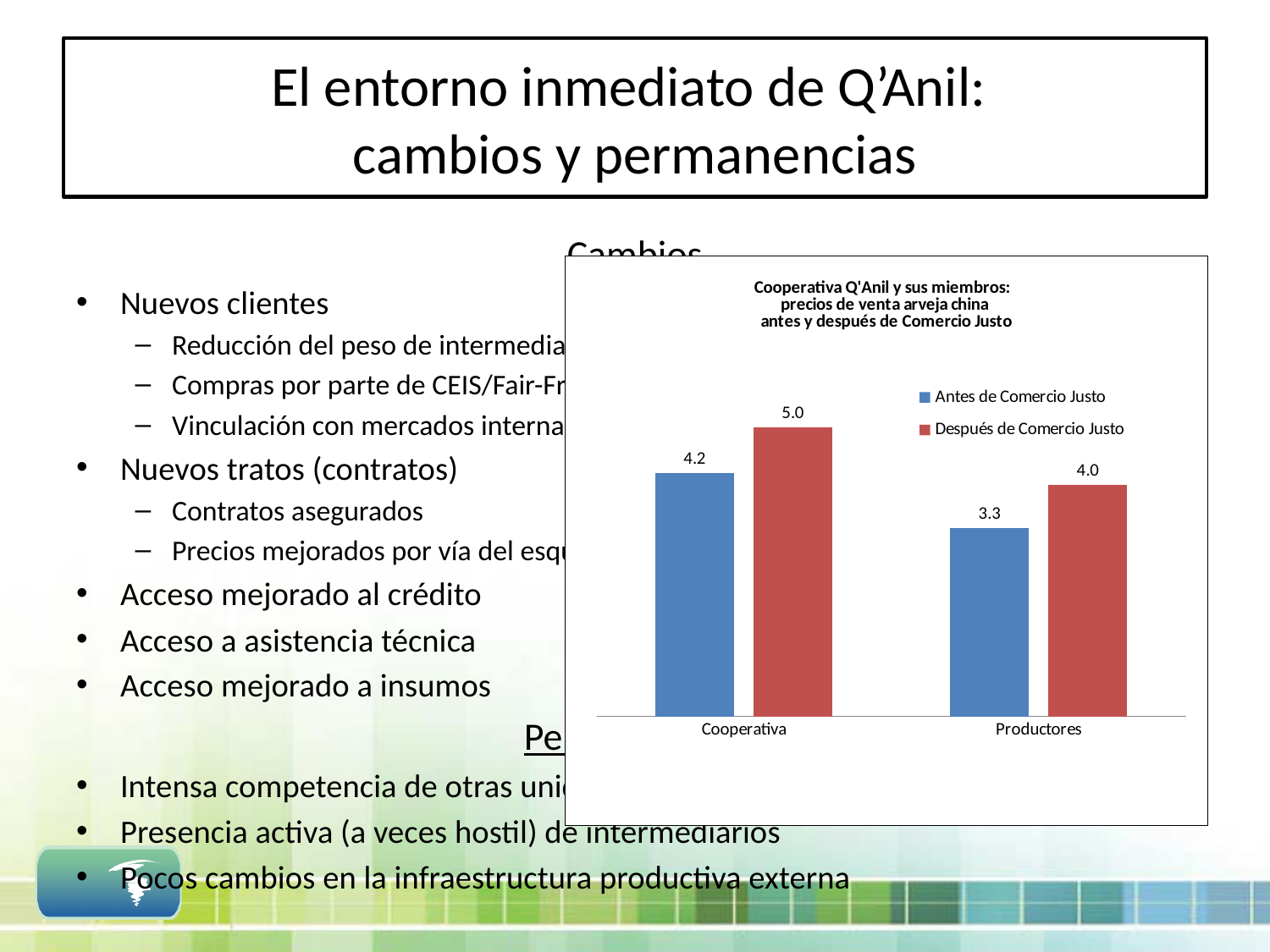
Which is larger for Productores: the Antes de Comercio Justo value or the Después de Comercio Justo value? Después de Comercio Justo How many series does the chart legend list? 2 What is the difference between the Después de Comercio Justo and Antes de Comercio Justo values for Cooperativa? 0.8 What is the difference between the Después de Comercio Justo and Antes de Comercio Justo values for Productores? 0.7 Which category has the highest value in the Después de Comercio Justo series? Cooperativa What is the value for Cooperativa in the Antes de Comercio Justo series? 4.2 How many categories are shown on the x axis of the chart? 2 What is the value for Productores in the Antes de Comercio Justo series? 3.3 Which category has the lowest value in the Antes de Comercio Justo series? Productores What is the value for Productores in the Después de Comercio Justo series? 4.0 What is the value for Cooperativa in the Después de Comercio Justo series? 5.0 What kind of chart is shown on the slide? Bar chart